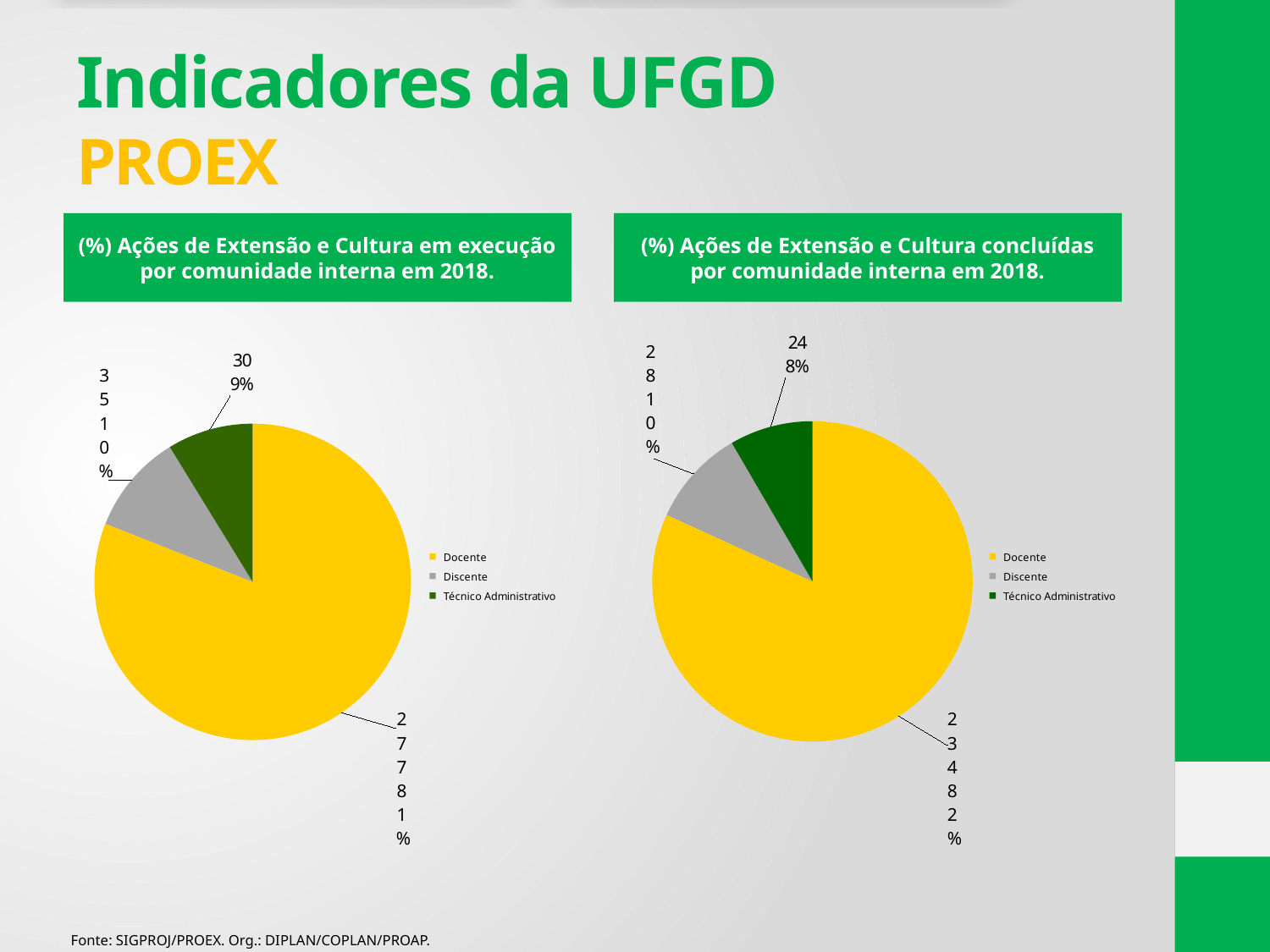
In the chart '(%) Ações de Extensão e Cultura concluídas por comunidade interna em 2018', what percentage share does Docente have? 82% In the chart '(%) Ações de Extensão e Cultura em execução por comunidade interna em 2018', what percentage share does Técnico Administrativo have? 9% What kind of chart is used for '(%) Ações de Extensão e Cultura em execução por comunidade interna em 2018'? Pie chart In the chart '(%) Ações de Extensão e Cultura em execução por comunidade interna em 2018', what percentage share does Discente have? 10% In the chart '(%) Ações de Extensão e Cultura concluídas por comunidade interna em 2018', what percentage share does Técnico Administrativo have? 8% In the chart '(%) Ações de Extensão e Cultura em execução por comunidade interna em 2018', which category has the smallest slice? Técnico Administrativo In the chart '(%) Ações de Extensão e Cultura concluídas por comunidade interna em 2018', which is larger, the Discente slice or the Técnico Administrativo slice? Discente In the chart '(%) Ações de Extensão e Cultura em execução por comunidade interna em 2018', what percentage share does Docente have? 81% In the chart '(%) Ações de Extensão e Cultura em execução por comunidade interna em 2018', what colour is the Docente slice? Yellow In the chart '(%) Ações de Extensão e Cultura em execução por comunidade interna em 2018', which category has the largest slice? Docente In the chart '(%) Ações de Extensão e Cultura concluídas por comunidade interna em 2018', which category has the largest slice? Docente How many categories does the legend list in the chart '(%) Ações de Extensão e Cultura concluídas por comunidade interna em 2018'? 3